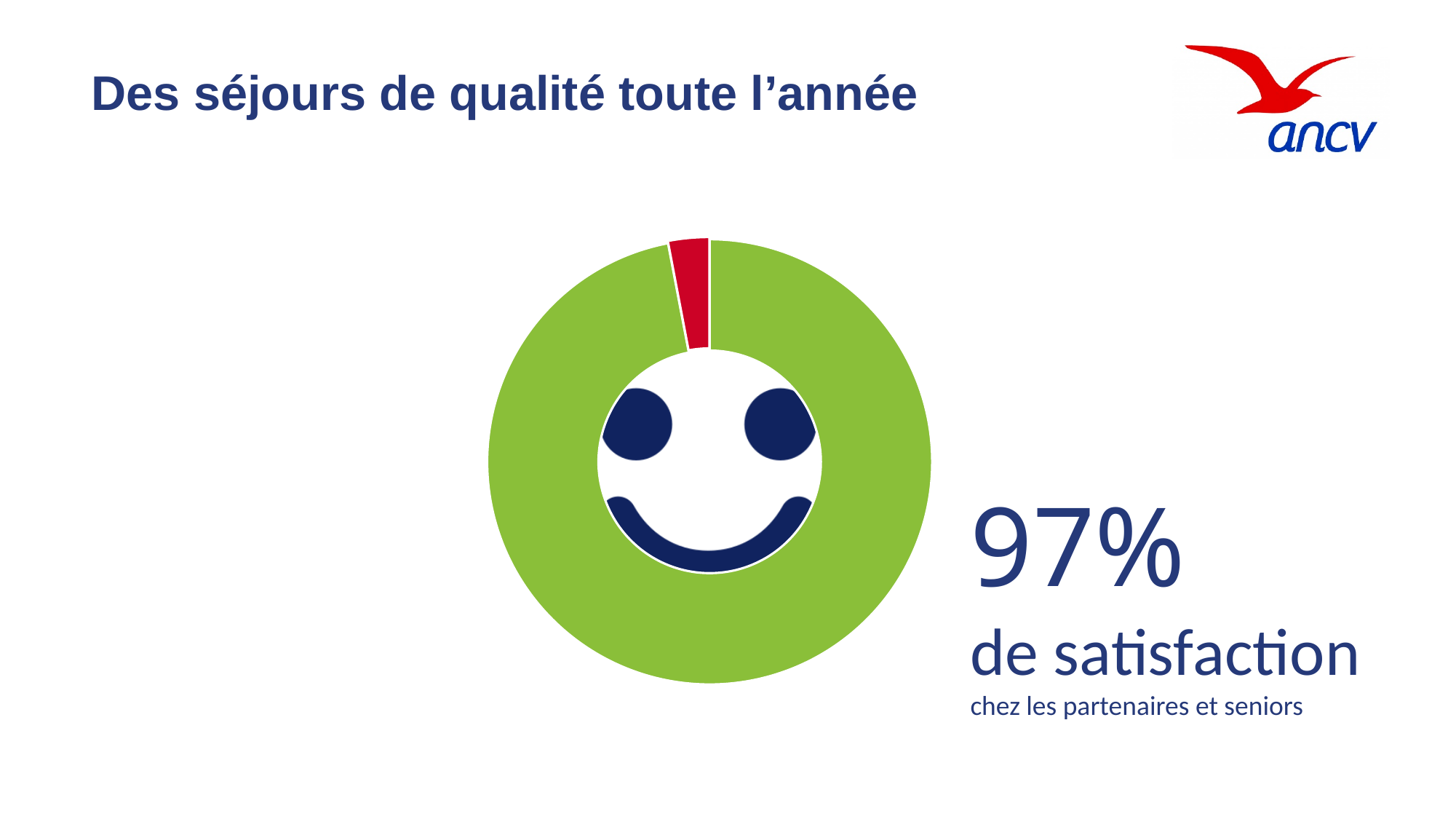
Which slice of the donut chart is the largest? the green slice What kind of chart is shown on the slide? donut chart What is the title of the slide containing the donut chart? Des séjours de qualité toute l'année Which slice of the donut chart is the smallest? the red slice What does the 97% figure next to the donut chart measure? satisfaction (de satisfaction chez les partenaires et seniors) What share of the donut chart is taken by the green slice? 97% Which is larger in the donut chart, the green slice or the red slice? the green slice How many slices does the donut chart have? 2 What percentage does the green slice of the donut chart represent? 97%